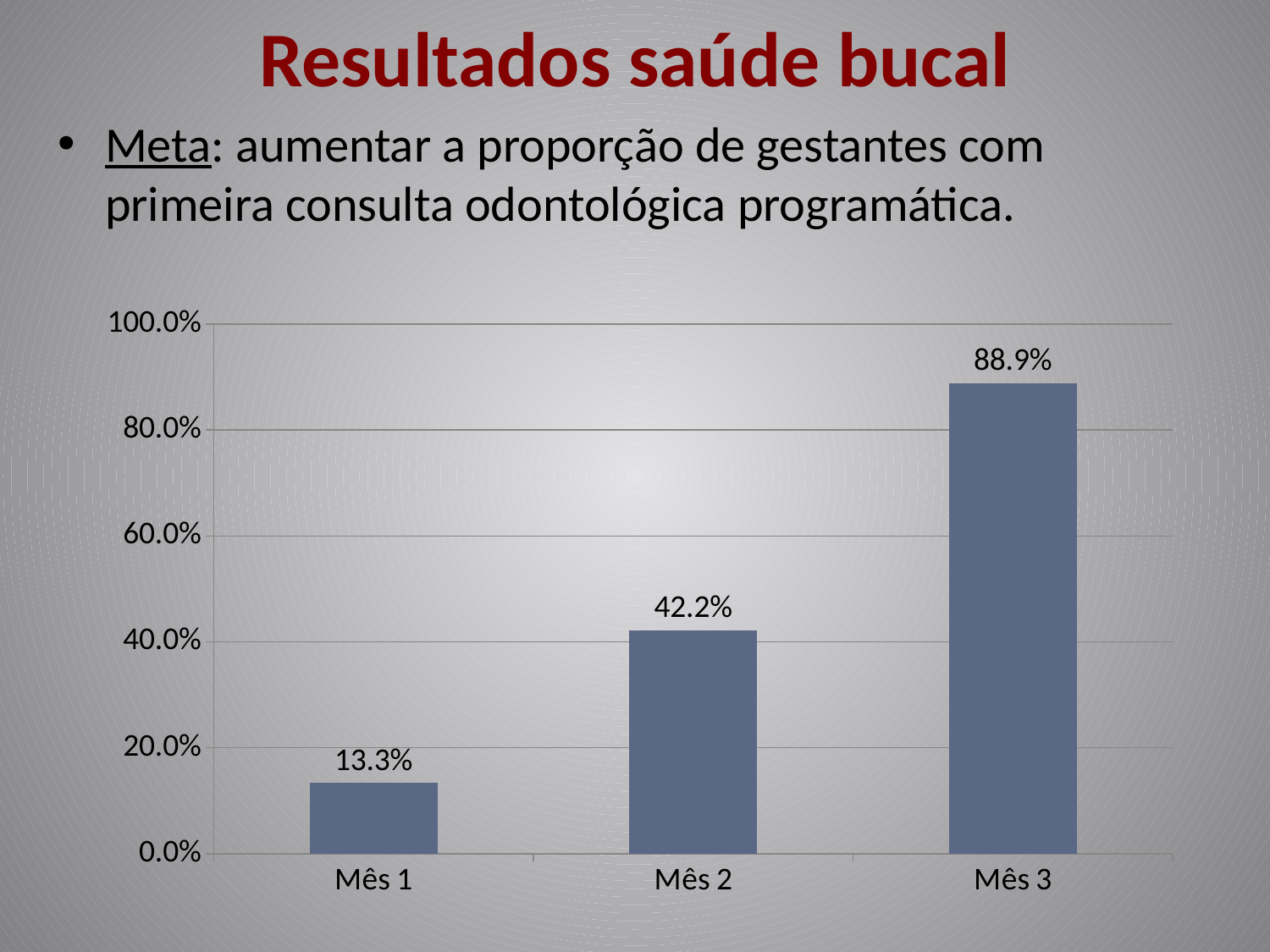
Which month has the lowest value? Mês 1 What kind of chart is shown on the slide? bar chart What is the difference between the values for Mês 2 and Mês 1? 28.9% What is the value for Mês 1? 13.3% How many months are shown on the x axis? 3 What is the difference between the values for Mês 3 and Mês 2? 46.7% Is the value for Mês 3 greater or less than 80.0%? greater Which month has the highest value? Mês 3 Which is larger, the value for Mês 1 or the value for Mês 2? Mês 2 Do the values rise or fall from Mês 1 to Mês 3? rise What is the value for Mês 2? 42.2% What is the value for Mês 3? 88.9%